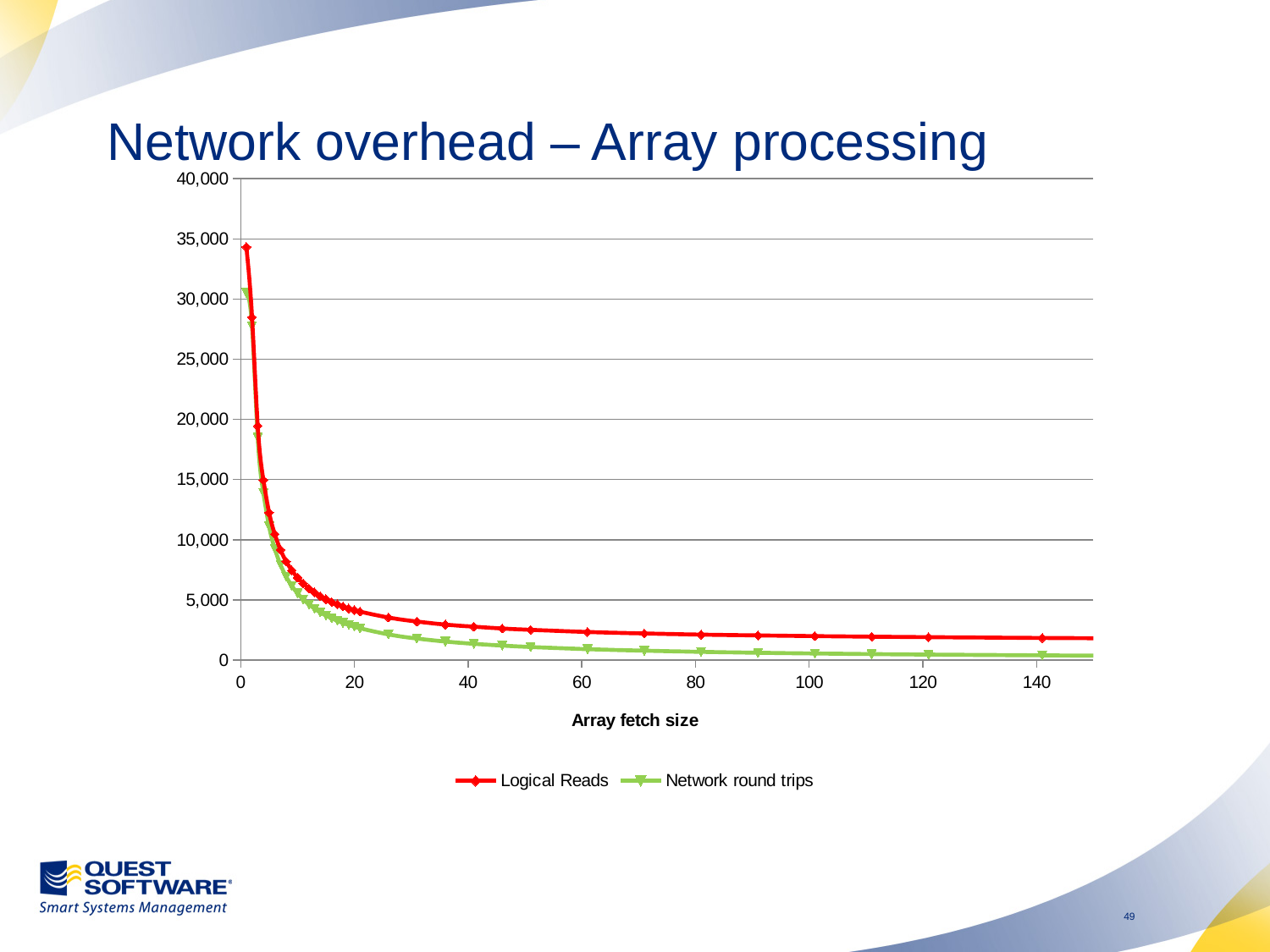
Do the Network round trips values rise or fall as the array fetch size increases? fall Is the Logical Reads value at the smallest array fetch size greater or less than 30,000? greater Is the Logical Reads value at array fetch size 140 greater or less than 5,000? less Is the Network round trips value at array fetch size 20 greater or less than 5,000? less What is the title of the chart? Network overhead – Array processing At array fetch size 140, which series has the higher value, Logical Reads or Network round trips? Logical Reads At the smallest array fetch size, which series has the higher value, Logical Reads or Network round trips? Logical Reads What kind of chart is shown on the slide? line chart How many series does the legend list? 2 What is the label of the x axis? Array fetch size Do the Logical Reads values rise or fall as the array fetch size increases? fall